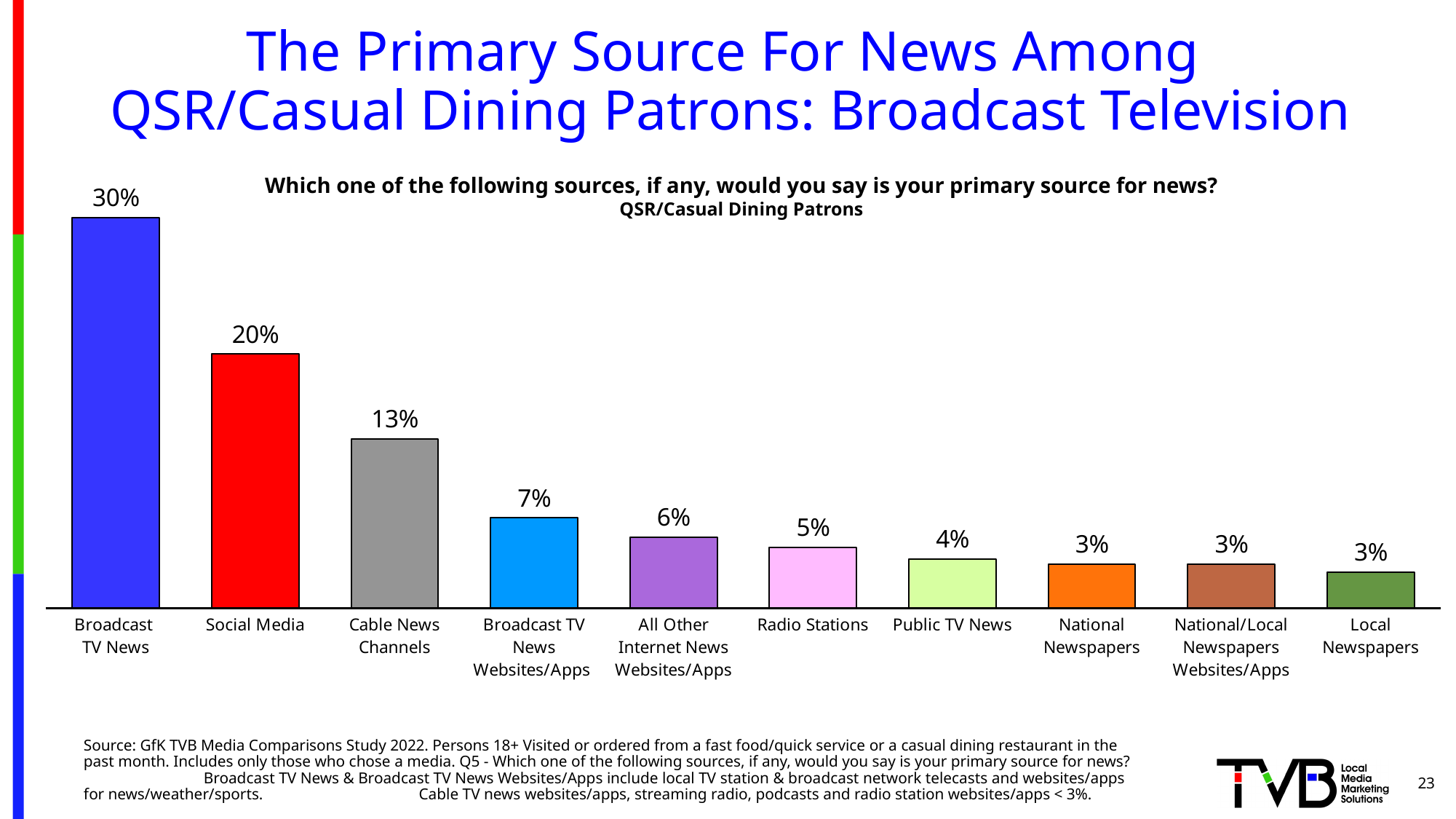
How many news source categories are shown on the chart? 10 What percentage of QSR/Casual Dining Patrons say Broadcast TV News is their primary source for news? 30% What is the difference between the values for Cable News Channels and Broadcast TV News Websites/Apps? 6% What is the difference between the values for Broadcast TV News and Social Media? 10% Do the values rise or fall moving from left to right across the chart? Fall What is the value shown for Cable News Channels? 13% What is the value shown for Radio Stations? 5% What colour is the bar for Social Media? Red What is the value shown for Social Media? 20% Which is larger, the value for All Other Internet News Websites/Apps or the value for Public TV News? All Other Internet News Websites/Apps What kind of chart is shown on the slide? Bar chart Which news source has the highest value on the chart? Broadcast TV News